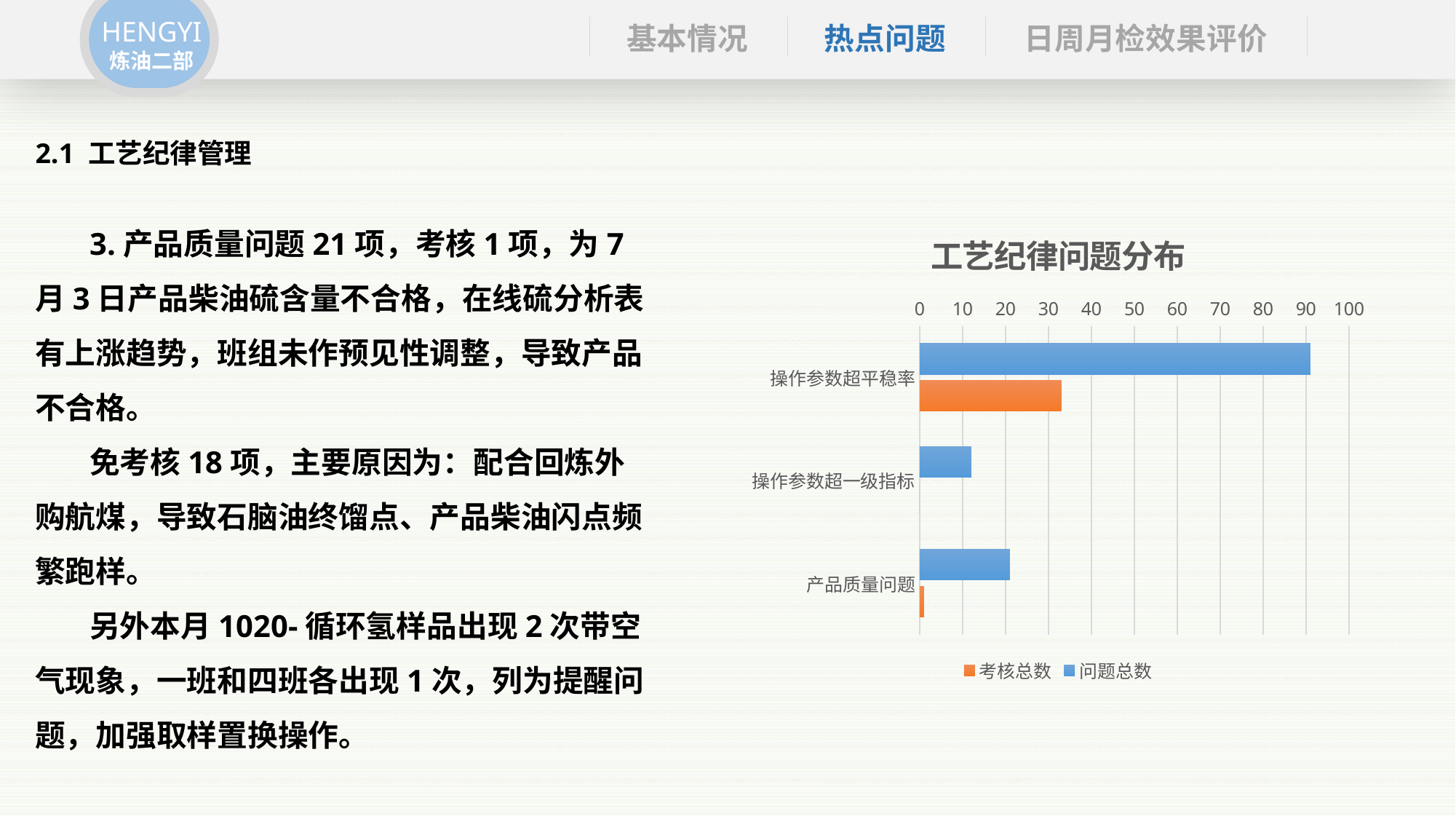
What kind of chart is shown on the slide? bar chart For 操作参数超平稳率, which series has the larger value, 问题总数 or 考核总数? 问题总数 Is the 问题总数 value for 操作参数超平稳率 greater or less than 80? greater How many categories are shown on the chart's vertical axis? 3 How many series does the legend of the chart list? 2 Which category has the lowest 问题总数 value? 操作参数超一级指标 Which has the larger 问题总数 value, 产品质量问题 or 操作参数超一级指标? 产品质量问题 What colour represents the 考核总数 series in the chart? orange Is the 考核总数 value for 操作参数超平稳率 greater or less than 40? less What is the title of the chart? 工艺纪律问题分布 Which category has the highest 问题总数 value? 操作参数超平稳率 Is the 问题总数 value for 产品质量问题 greater or less than 30? less